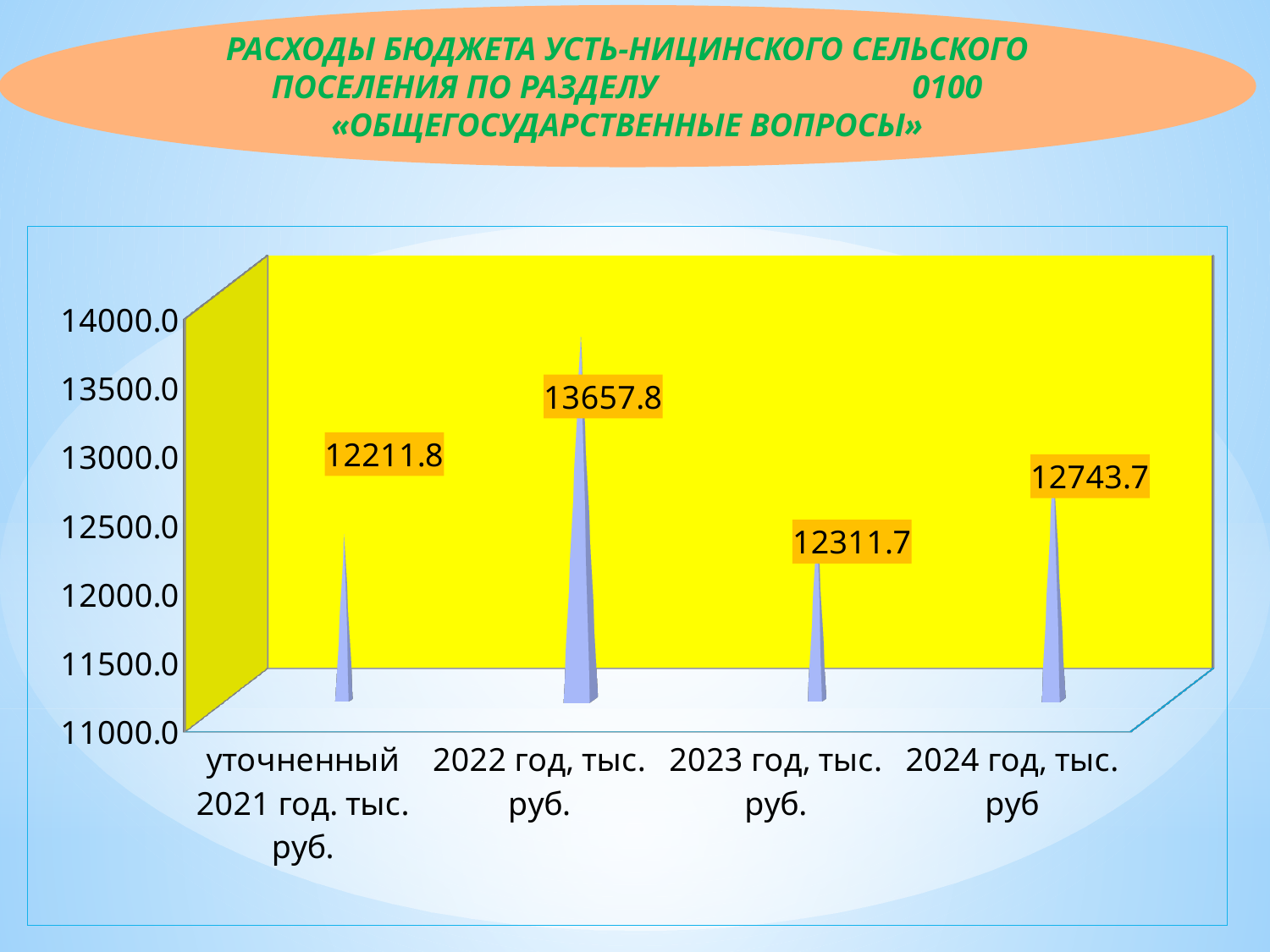
Is the value for 2022 год greater or less than 13500.0? greater Which is larger, the value for 2024 год or the value for 2023 год? 2024 год, тыс. руб What is the value for уточненный 2021 год. тыс. руб.? 12211.8 What is the value for 2023 год, тыс. руб.? 12311.7 Which category has the highest value? 2022 год, тыс. руб. What is the difference between the values for 2022 год and 2023 год? 1346.1 What is the value for 2024 год, тыс. руб? 12743.7 What is the value for 2022 год, тыс. руб.? 13657.8 How many categories are shown on the x axis? 4 What is the difference between the values for 2024 год and 2023 год? 432.0 What kind of chart is shown on the slide? bar chart Which category has the lowest value? уточненный 2021 год. тыс. руб.